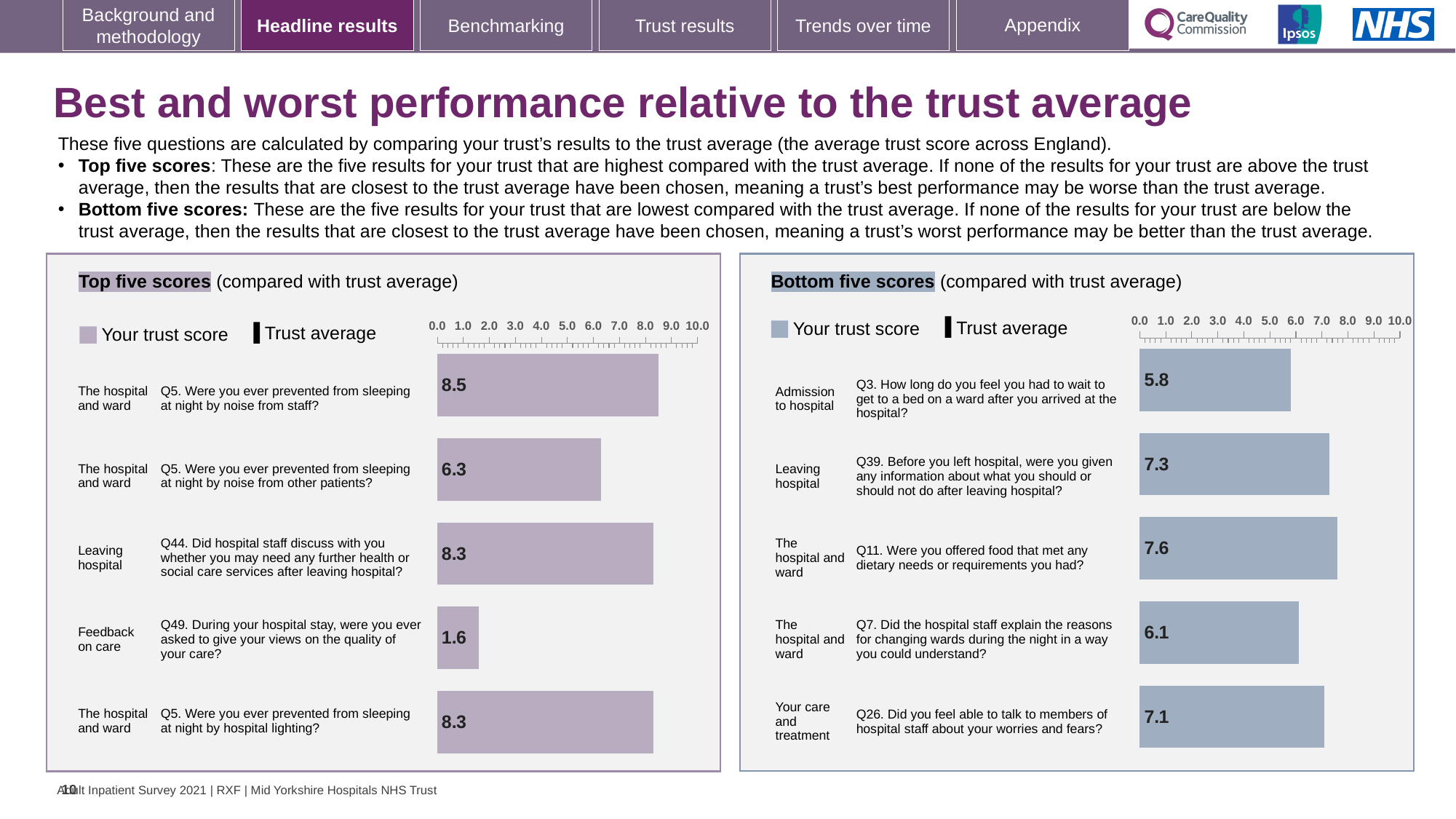
In the Bottom five scores chart, which question has the lowest trust score? Q3. How long do you feel you had to wait to get to a bed on a ward after you arrived at the hospital? How many bars are shown in the Top five scores chart? 5 What type of chart is used in the Bottom five scores panel? Bar chart In the Bottom five scores chart, what is the trust score for Q11 (offered food that met any dietary needs)? 7.6 How many entries does the legend of the Top five scores chart list? 2 In the Bottom five scores chart, which has the higher trust score: Q39 (information about what to do after leaving hospital) or Q26 (able to talk to staff about worries and fears)? Q39 In the Top five scores chart, what is the trust score for Q49 (asked to give your views on the quality of your care)? 1.6 In the Top five scores chart, which question has the highest trust score? Q5. Were you ever prevented from sleeping at night by noise from staff? In the Top five scores chart, which question has the lowest trust score? Q49. During your hospital stay, were you ever asked to give your views on the quality of your care? In the Bottom five scores chart, what is the trust score for Q3 (how long you had to wait to get to a bed on a ward)? 5.8 In the Top five scores chart, what is the difference between the score for Q5 (noise from staff) and the score for Q49? 6.9 In the Bottom five scores chart, what is the difference between the highest score (Q11) and the lowest score (Q3)? 1.8